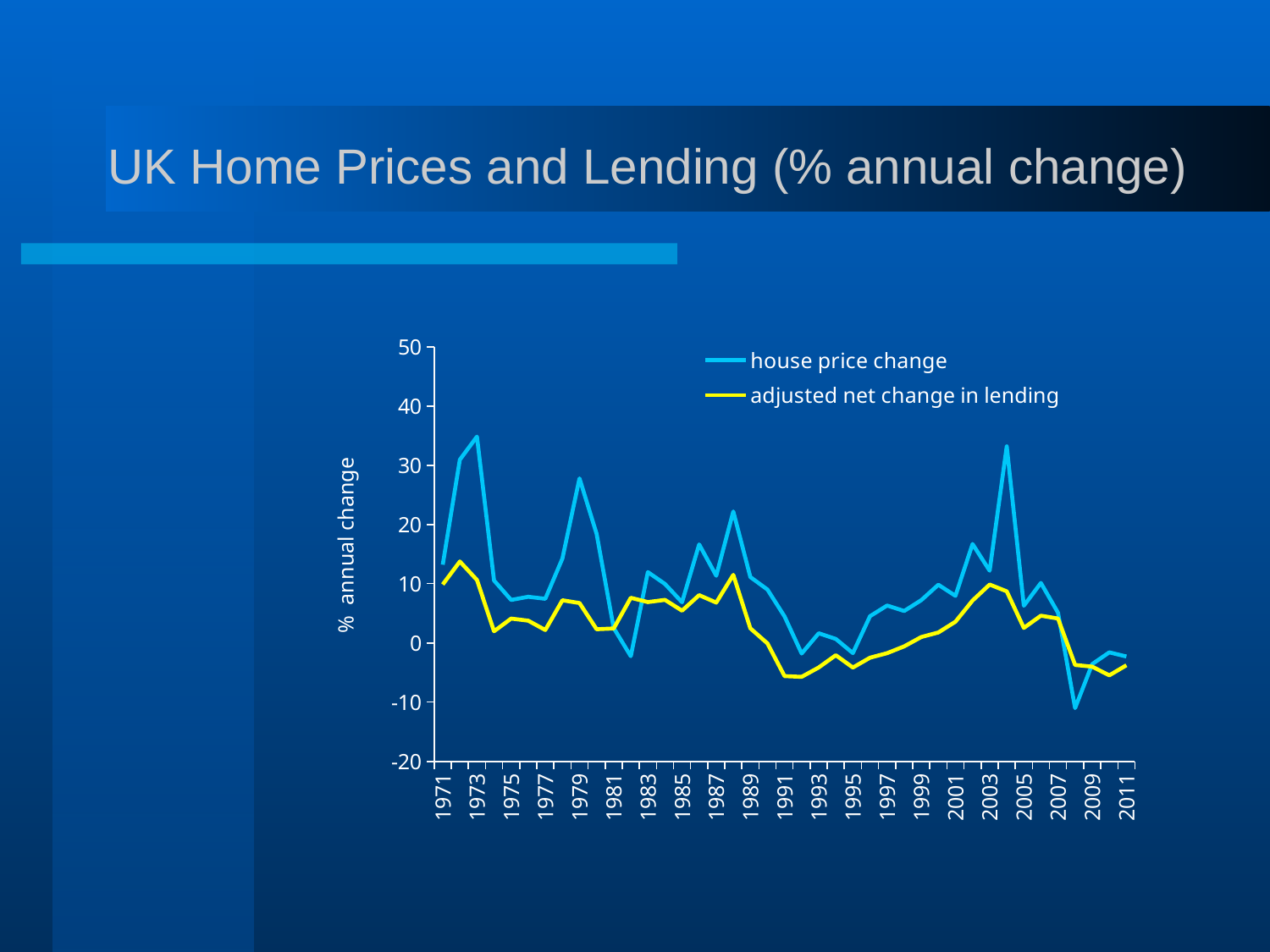
How many series does the legend list? 2 In which year does house price change reach its lowest value? 2008 In 1973, which series has the larger value, house price change or adjusted net change in lending? house price change What is the label on the vertical axis? % annual change Is the value for house price change in 1979 greater or less than 20? greater Does house price change rise or fall between 2004 and 2008? fall Is the value for adjusted net change in lending in 1991 greater or less than 0? less What kind of chart is shown on the slide? line chart Is the value for house price change in 2008 greater or less than 0? less What are the two series named in the legend? house price change; adjusted net change in lending